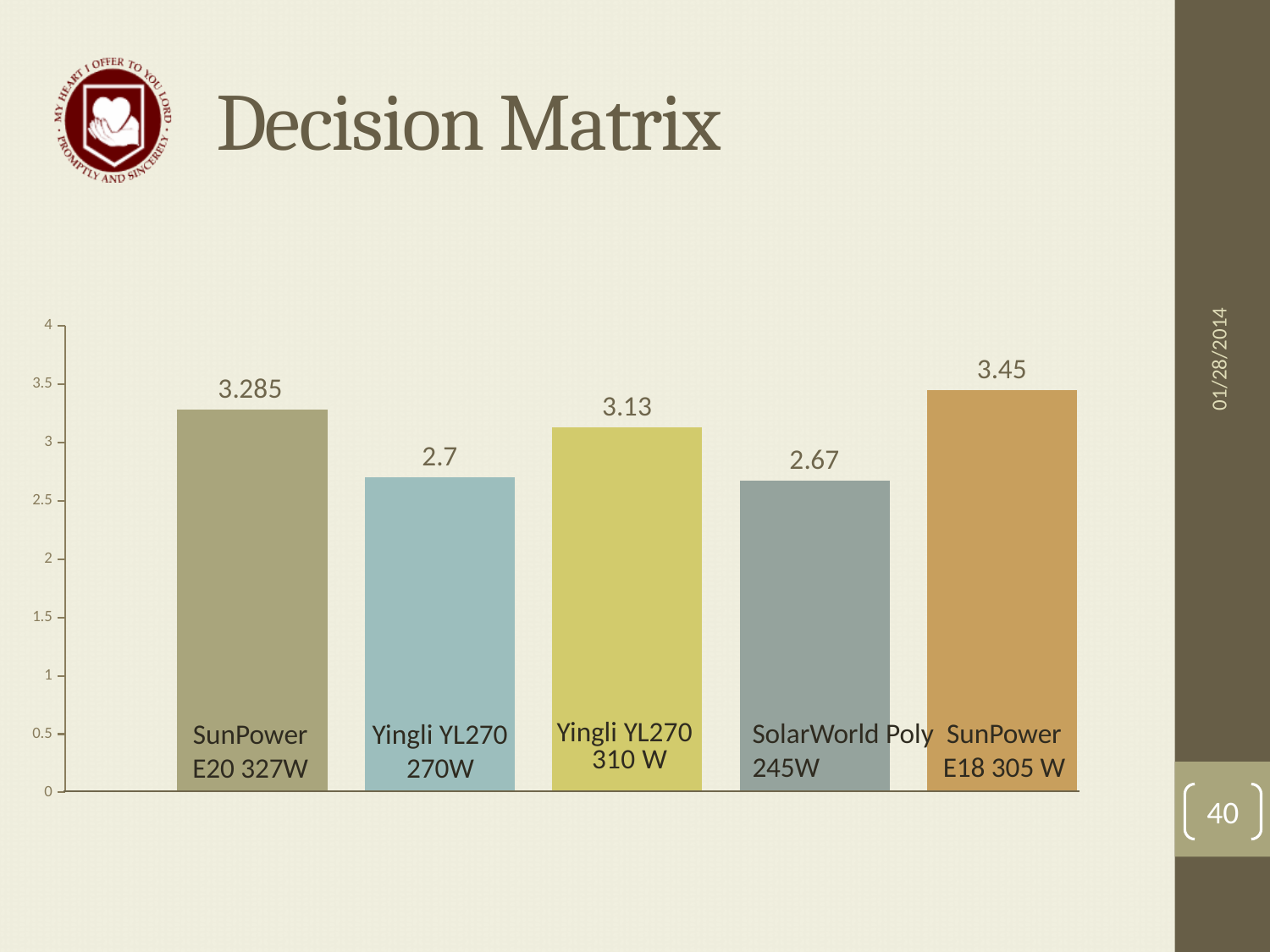
What is the title of the slide containing the chart? Decision Matrix What is the value for SunPower E18 305 W? 3.45 What is the value for SunPower E20 327W? 3.285 What is the value for Yingli YL270 270W? 2.7 What is the difference between the values for SunPower E18 305 W and SunPower E20 327W? 0.165 What kind of chart is shown on the slide? Bar chart What is the value for SolarWorld Poly 245W? 2.67 Which is larger, the value for Yingli YL270 310 W or the value for SolarWorld Poly 245W? Yingli YL270 310 W Which category has the highest value? SunPower E18 305 W Which category has the lowest value? SolarWorld Poly 245W What is the value for Yingli YL270 310 W? 3.13 How many categories are shown in the chart? 5